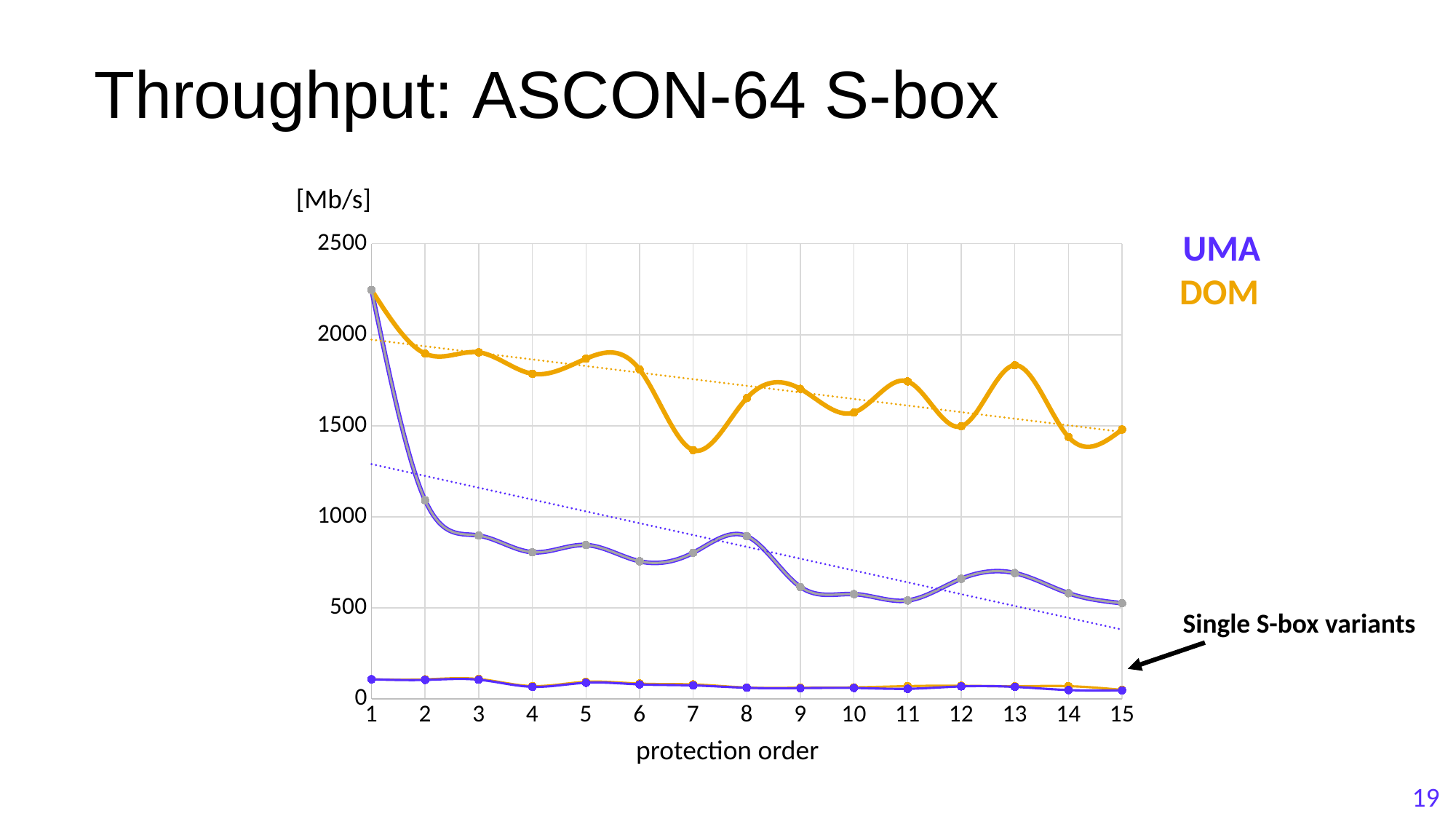
At which protection order is the DOM throughput highest? 1 Is the DOM throughput at protection order 13 greater or less than 1500? greater How many protection orders are plotted along the x axis? 15 Does the UMA throughput rise or fall overall as the protection order increases from 1 to 15? fall Is the UMA throughput at protection order 2 greater or less than 1000? greater At protection order 10, which has the higher throughput, DOM or UMA? DOM What unit is shown for the y axis? [Mb/s] What is the label of the x axis? protection order What kind of chart is shown on the slide? line chart Is the DOM throughput at protection order 1 greater or less than 2000? greater